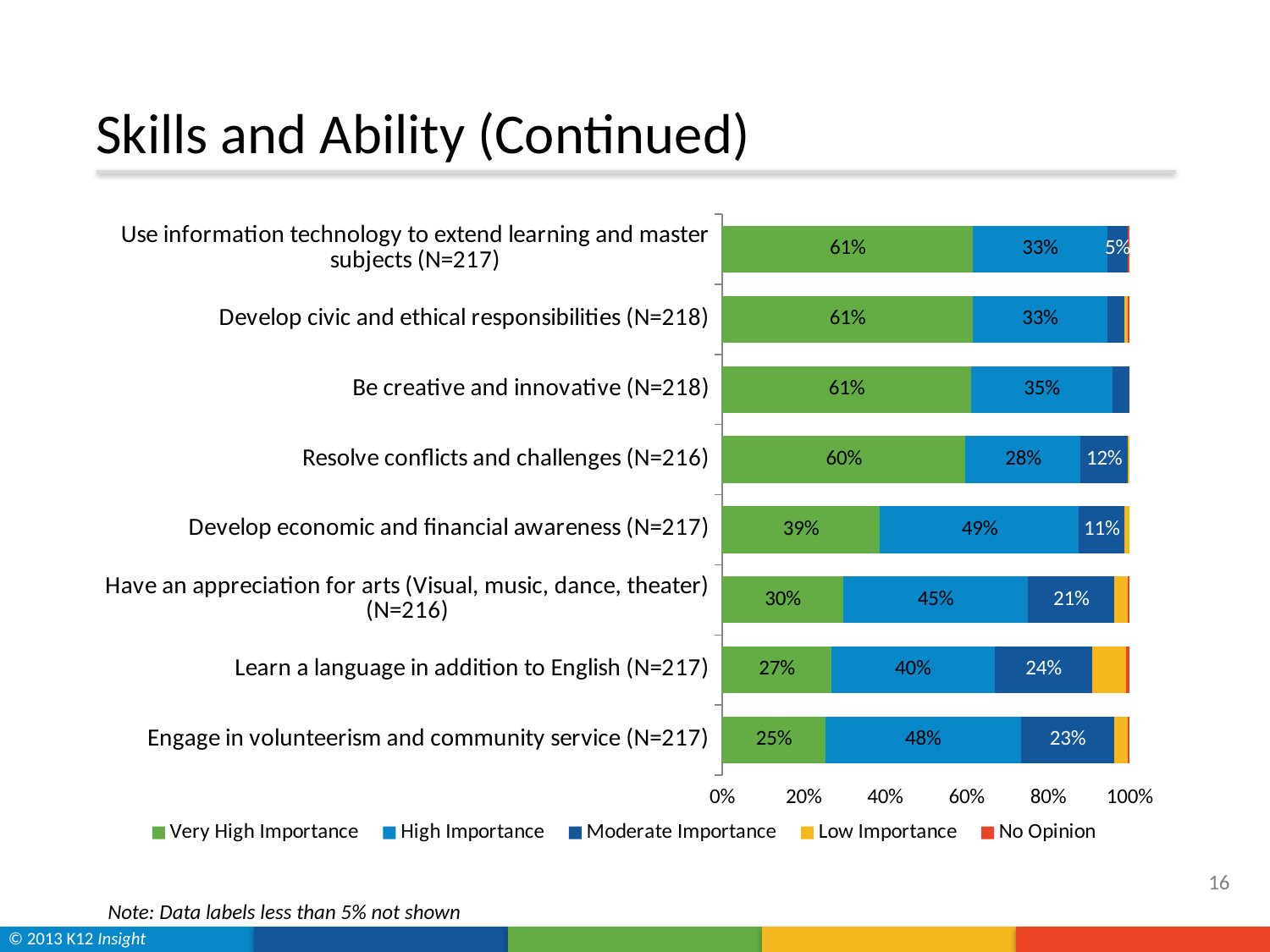
What colour represents the Low Importance series in the legend? Yellow What is the difference between the Very High Importance values for "Be creative and innovative (N=218)" and "Have an appreciation for arts (Visual, music, dance, theater) (N=216)"? 31% What is the Very High Importance value for "Resolve conflicts and challenges (N=216)"? 60% Is the Very High Importance value for "Develop civic and ethical responsibilities (N=218)" greater or less than 40%? greater Which is larger: the Moderate Importance value for "Engage in volunteerism and community service (N=217)" or for "Have an appreciation for arts (Visual, music, dance, theater) (N=216)"? Engage in volunteerism and community service (N=217) What is the Moderate Importance value for "Learn a language in addition to English (N=217)"? 24% Which category has the highest High Importance value? Develop economic and financial awareness (N=217) What type of chart is shown on the slide? Stacked bar chart How many series does the legend list? 5 How many categories (skills) are plotted in the chart? 8 What is the High Importance value for "Develop economic and financial awareness (N=217)"? 49% Which category has the lowest Very High Importance value? Engage in volunteerism and community service (N=217)